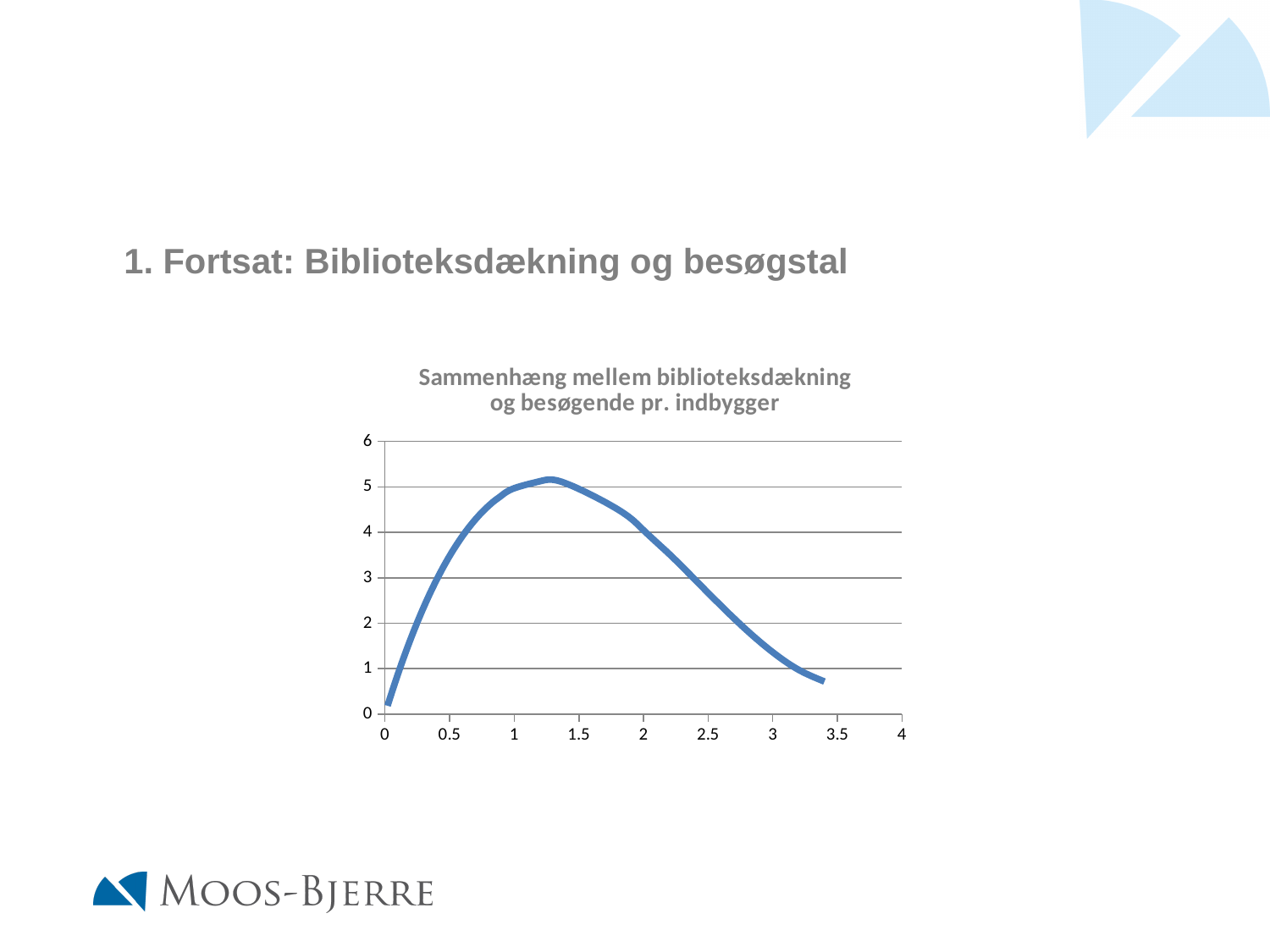
What is the highest value shown on the vertical axis? 6 Is the value of the line higher at x = 1 or at x = 3? x = 1 Does the line peak at an x value less than 2 or greater than 2? less than 2 Is the value of the line at x = 0.5 greater or less than 3? greater Is the value of the line at x = 2.5 greater or less than 3? less Does the line rise or fall between x = 2 and x = 3? fall What kind of chart is shown on the slide? line chart Is the value of the line at x = 3 greater or less than 2? less What is the title of the chart? Sammenhæng mellem biblioteksdækning og besøgende pr. indbygger Does the line rise or fall between x = 0 and x = 1? rise